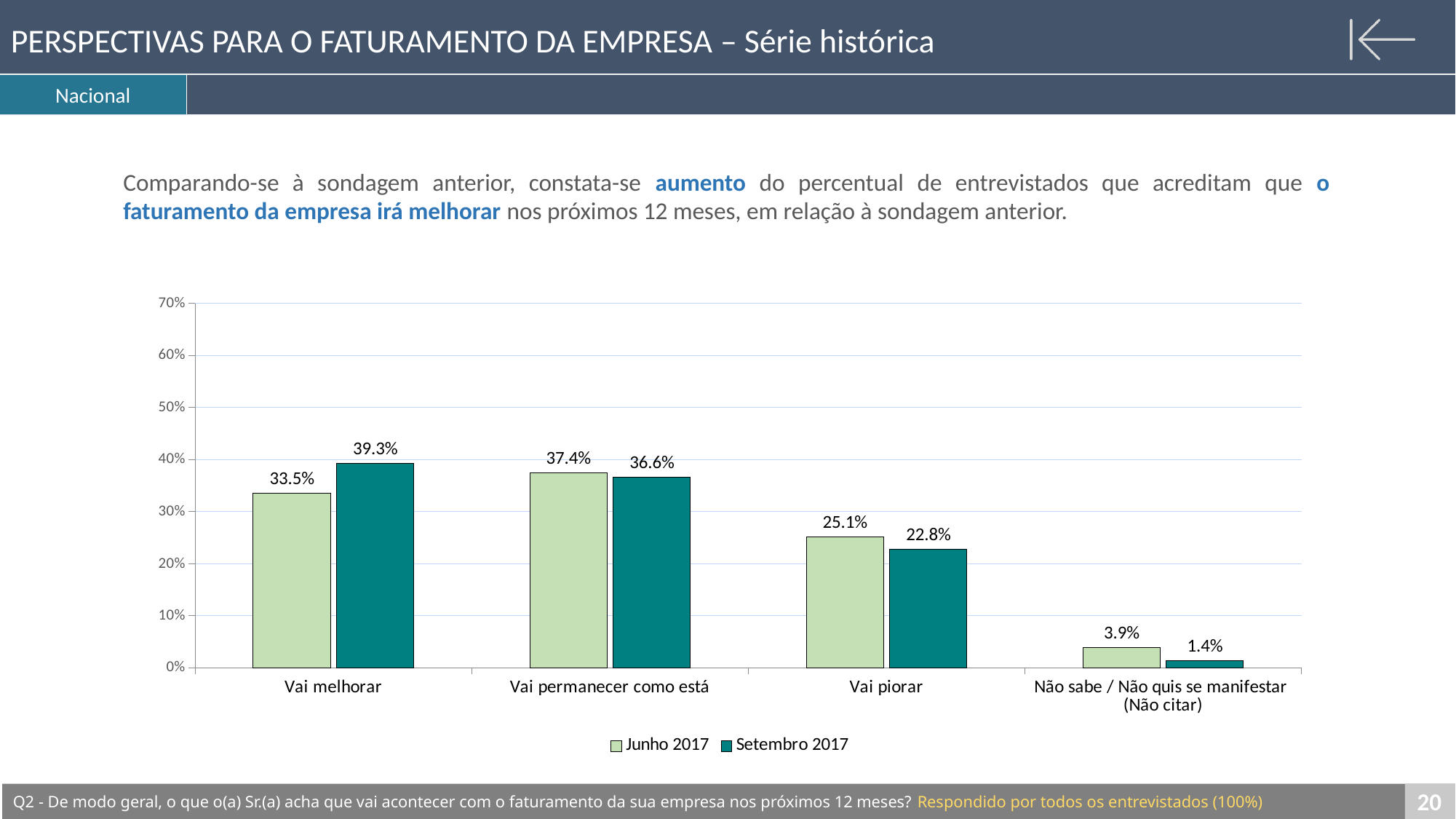
What is the difference between the Setembro 2017 and Junho 2017 values for "Vai melhorar"? 5.8% How many categories are shown on the x axis? 4 For "Vai piorar", which series has the larger value, Junho 2017 or Setembro 2017? Junho 2017 What is the value for "Vai melhorar" in the Setembro 2017 series? 39.3% What kind of chart is shown on the slide? Bar chart How many series does the legend list? 2 What is the value for "Não sabe / Não quis se manifestar (Não citar)" in the Setembro 2017 series? 1.4% What are the two series named in the legend? Junho 2017 and Setembro 2017 What is the value for "Vai piorar" in the Junho 2017 series? 25.1% Which category has the highest value in the Junho 2017 series? Vai permanecer como está Which category has the lowest value in the Setembro 2017 series? Não sabe / Não quis se manifestar (Não citar) Is the Setembro 2017 value for "Vai permanecer como está" greater or less than 30%? greater